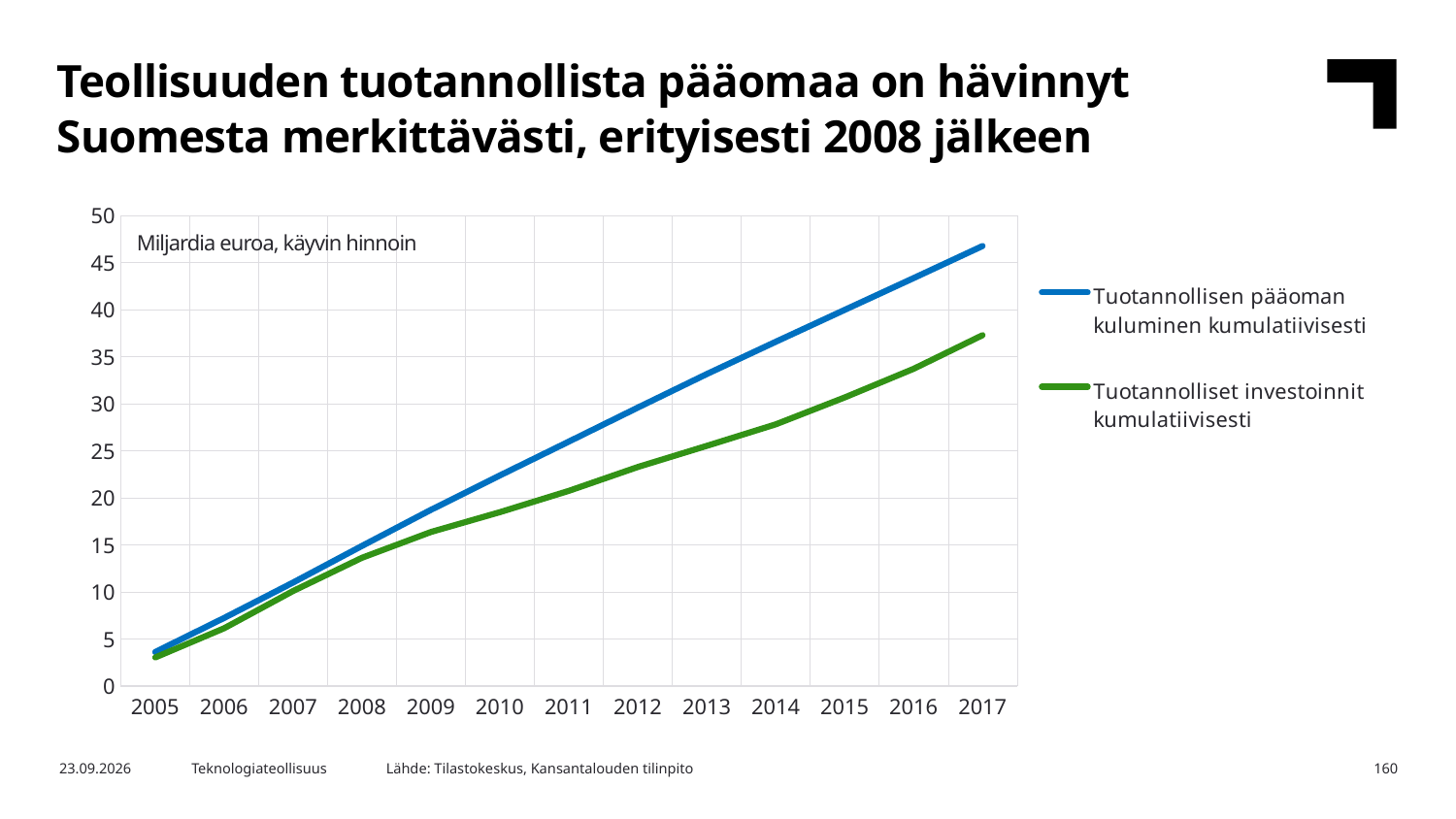
In 2017, which series has the larger value: 'Tuotannollisen pääoman kuluminen kumulatiivisesti' or 'Tuotannolliset investoinnit kumulatiivisesti'? Tuotannollisen pääoman kuluminen kumulatiivisesti Is the value for 'Tuotannollisen pääoman kuluminen kumulatiivisesti' in 2013 greater or less than 30? greater How many series does the legend list? 2 What kind of chart is shown on the slide? line chart Is the value for 'Tuotannolliset investoinnit kumulatiivisesti' in 2008 greater or less than 15? less How many years are plotted along the x axis? 13 Is the value for 'Tuotannolliset investoinnit kumulatiivisesti' in 2017 greater or less than 35? greater What unit is stated in the label inside the chart area? Miljardia euroa, käyvin hinnoin In which year does the 'Tuotannolliset investoinnit kumulatiivisesti' series reach its highest value? 2017 In which year is the 'Tuotannollisen pääoman kuluminen kumulatiivisesti' series at its lowest value? 2005 Do the values of the 'Tuotannollisen pääoman kuluminen kumulatiivisesti' series rise or fall from 2005 to 2017? rise